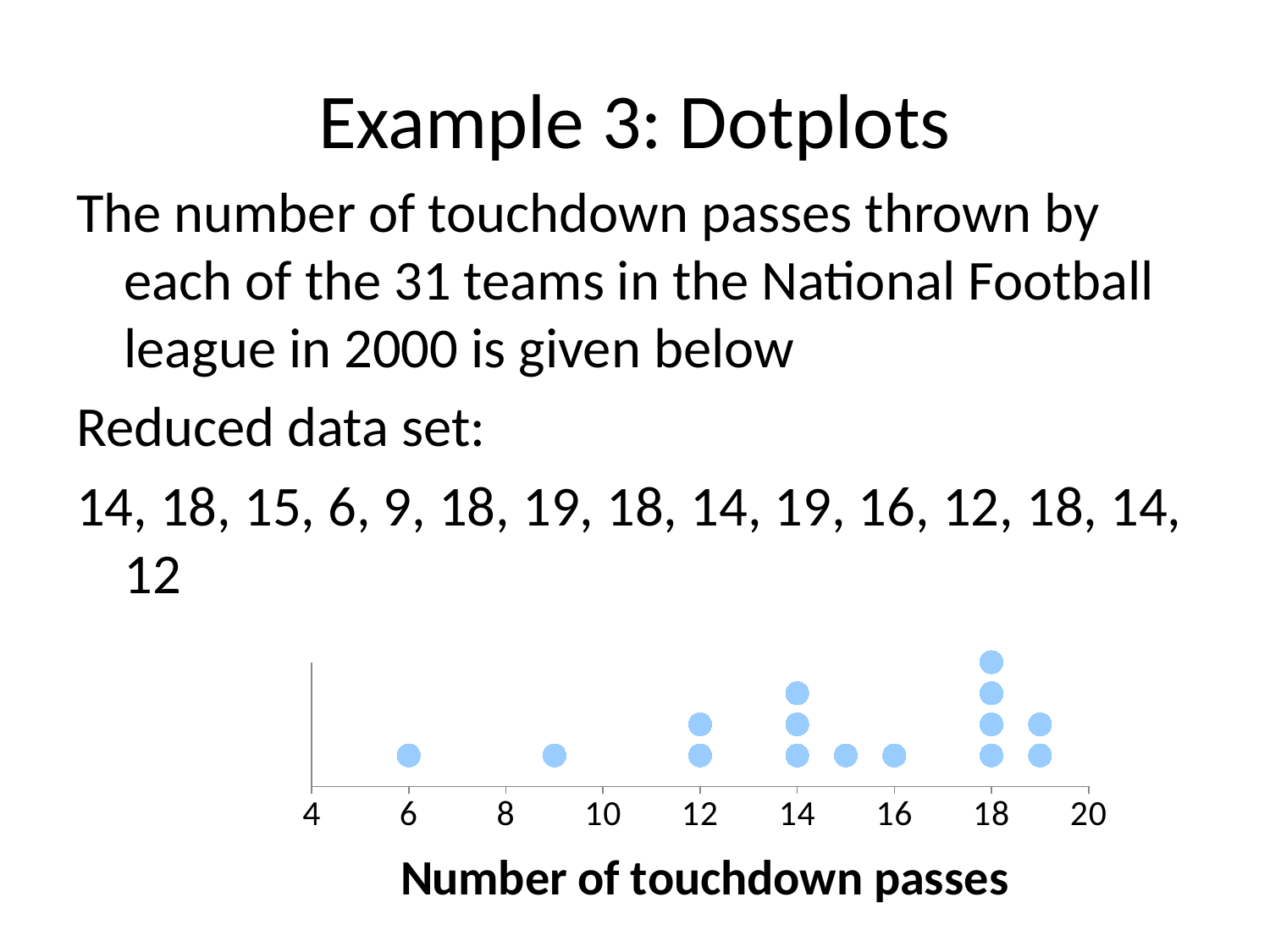
Which number of touchdown passes has the most dots in the dot plot? 18 How many dots are stacked above 18 in the dot plot? 4 Which has more dots in the dot plot, 14 or 19? 14 What is the label of the x axis of the dot plot? Number of touchdown passes How many dots are stacked above 12 in the dot plot? 2 How many distinct values on the x axis have at least one dot in the dot plot? 8 What kind of chart is shown on the slide? dot plot How many more dots are above 18 than above 15 in the dot plot? 3 What is the smallest number of touchdown passes shown by a dot in the dot plot? 6 How many dots are there in total in the dot plot? 15 What is the largest number of touchdown passes shown by a dot in the dot plot? 19 How many dots are stacked above 14 in the dot plot? 3